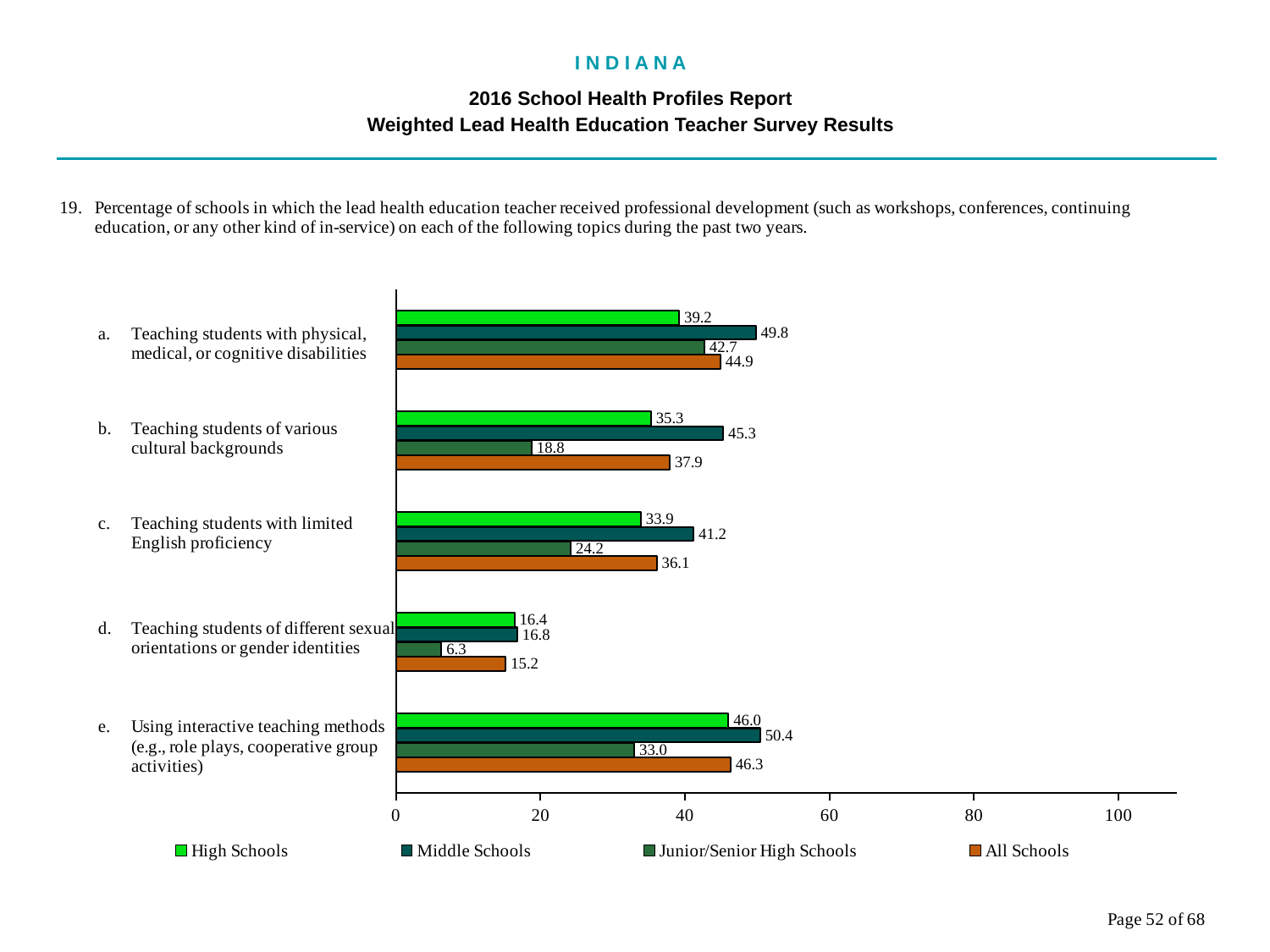
Which is larger for teaching students with limited English proficiency: the High Schools value or the Junior/Senior High Schools value? High Schools How many series does the legend list? 4 Which legend entry is shown in orange? All Schools What is the value for Middle Schools for teaching students with physical, medical, or cognitive disabilities? 49.8 Which topic has the lowest All Schools value? Teaching students of different sexual orientations or gender identities What is the High Schools value for using interactive teaching methods? 46.0 How many topics (categories) are shown on the chart? 5 What is the All Schools value for teaching students with limited English proficiency? 36.1 What is the difference between the Middle Schools and High Schools values for teaching students of various cultural backgrounds? 10.0 What kind of chart is shown on the slide? Bar chart What is the value for Junior/Senior High Schools for teaching students of various cultural backgrounds? 18.8 Which topic has the highest Middle Schools value? Using interactive teaching methods